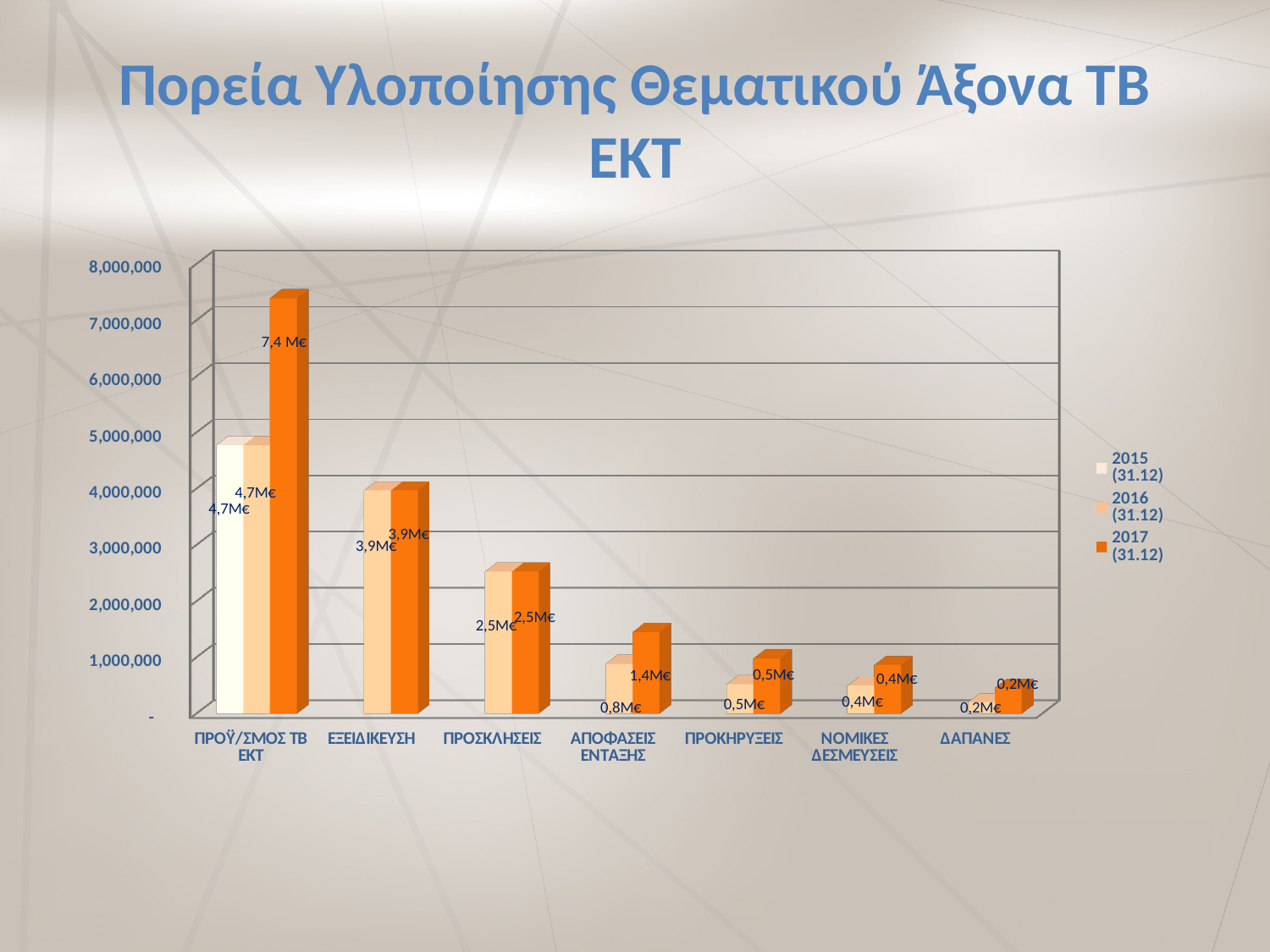
What kind of chart is shown on the slide? Bar chart Which category has the lowest value in the 2016 (31.12) series? ΔΑΠΑΝΕΣ How many series does the legend list? 3 Which is larger for ΑΠΟΦΑΣΕΙΣ ΕΝΤΑΞΗΣ: the 2016 (31.12) value or the 2017 (31.12) value? 2017 (31.12) How many categories are shown on the x axis? 7 Is the 2017 (31.12) value for ΠΡΟΣΚΛΗΣΕΙΣ greater or less than 3,000,000? less Which category has the highest value in the 2017 (31.12) series? ΠΡΟΫ/ΣΜΟΣ ΤΒ ΕΚΤ What is the value for ΕΞΕΙΔΙΚΕΥΣΗ in the 2017 (31.12) series? 3,9Μ€ What is the value for ΔΑΠΑΝΕΣ in the 2017 (31.12) series? 0,2Μ€ What is the value for ΠΡΟΫ/ΣΜΟΣ ΤΒ ΕΚΤ in the 2017 (31.12) series? 7,4 Μ€ What is the value for ΑΠΟΦΑΣΕΙΣ ΕΝΤΑΞΗΣ in the 2016 (31.12) series? 0,8Μ€ What is the difference between the 2017 (31.12) and 2016 (31.12) values for ΠΡΟΫ/ΣΜΟΣ ΤΒ ΕΚΤ? 2,7 Μ€